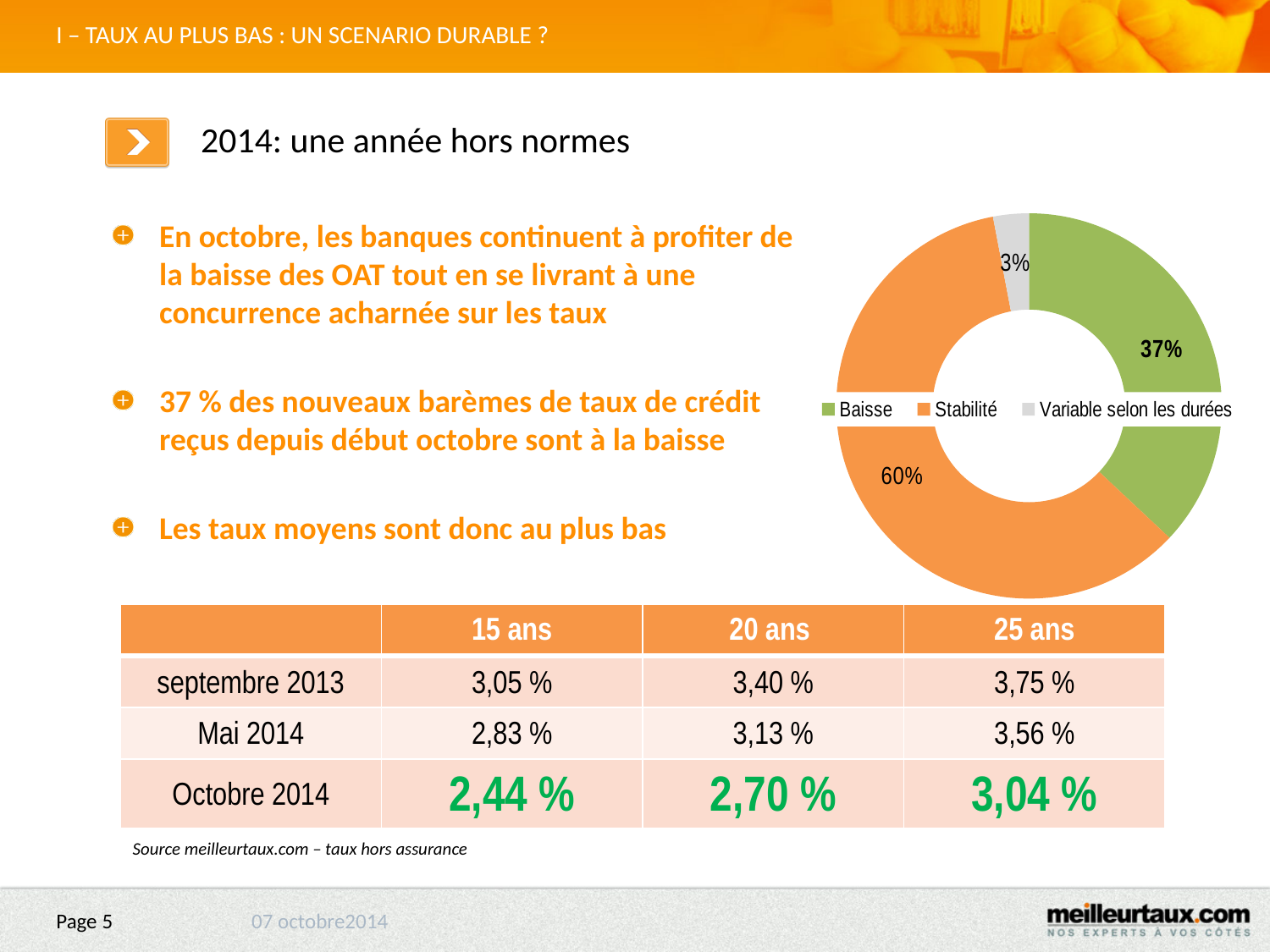
Which category has the largest share in the doughnut chart? Stabilité How many categories does the doughnut chart show? 3 What kind of chart is shown on the slide? Doughnut chart What share of the doughnut chart is labelled "Stabilité"? 60% What colour is the "Baisse" slice in the doughnut chart? Green What share of the doughnut chart is labelled "Variable selon les durées"? 3% What share of the doughnut chart is labelled "Baisse"? 37% What is the difference in percentage points between the "Stabilité" and "Baisse" shares in the doughnut chart? 23 What colour is the "Stabilité" slice in the doughnut chart? Orange How many entries does the legend of the doughnut chart list? 3 Which category has the smallest share in the doughnut chart? Variable selon les durées Which is larger in the doughnut chart, the share for "Baisse" or the share for "Variable selon les durées"? Baisse